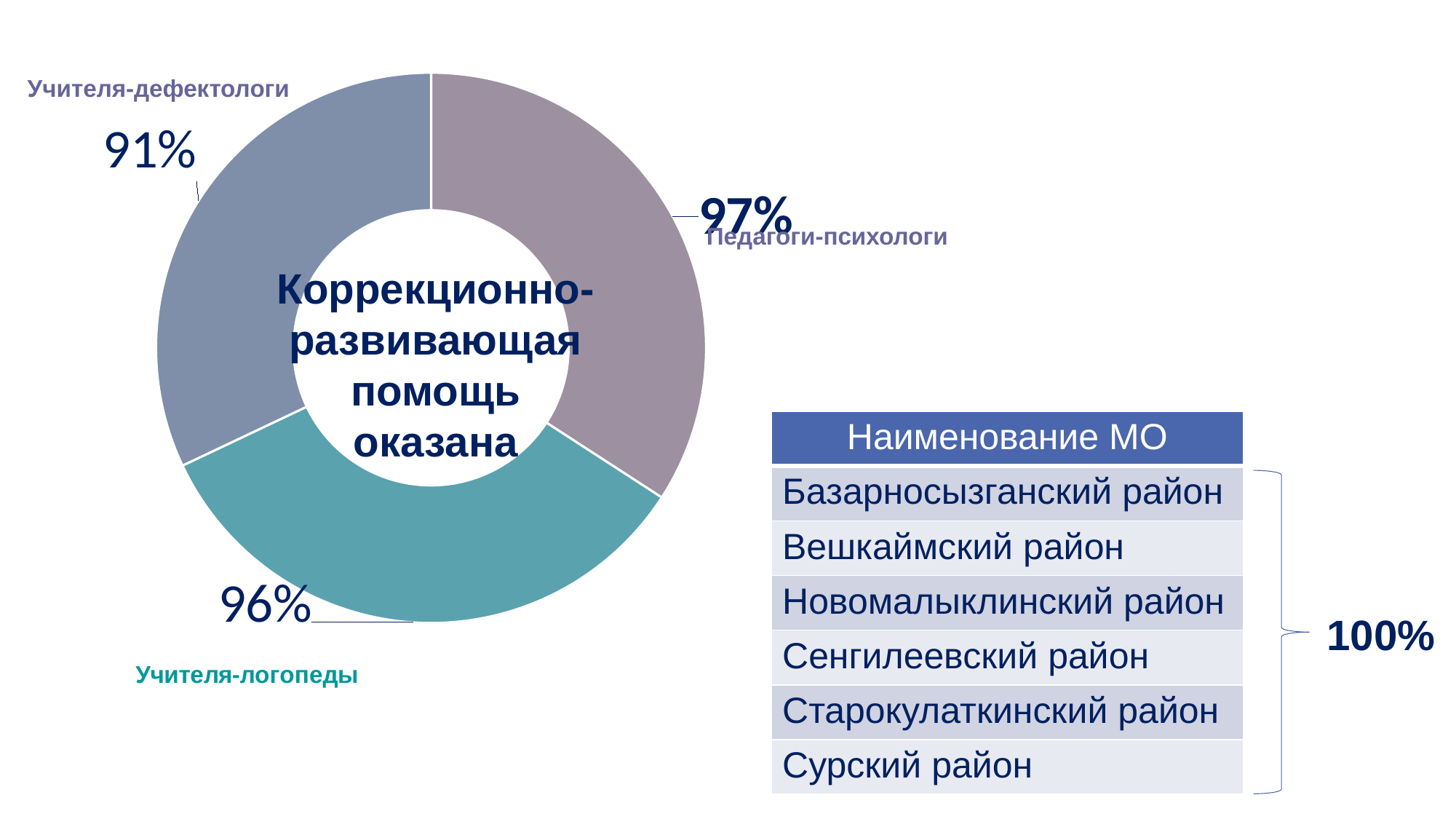
What value is shown for Педагоги-психологи on the doughnut chart? 97% What kind of chart is shown on the slide? Doughnut chart What value is shown for Учителя-логопеды on the doughnut chart? 96% What text is written in the centre of the doughnut chart? Коррекционно-развивающая помощь оказана How many categories are shown on the doughnut chart? 3 What is the difference in percentage points between the values for Педагоги-психологи and Учителя-дефектологи? 6 Which has a larger value on the doughnut chart, Педагоги-психологи or Учителя-логопеды? Педагоги-психологи What value is shown for Учителя-дефектологи on the doughnut chart? 91% Which category on the doughnut chart has the highest value? Педагоги-психологи Which category on the doughnut chart has the lowest value? Учителя-дефектологи Which has a larger value on the doughnut chart, Учителя-логопеды or Учителя-дефектологи? Учителя-логопеды What is the difference in percentage points between the values for Учителя-логопеды and Учителя-дефектологи? 5